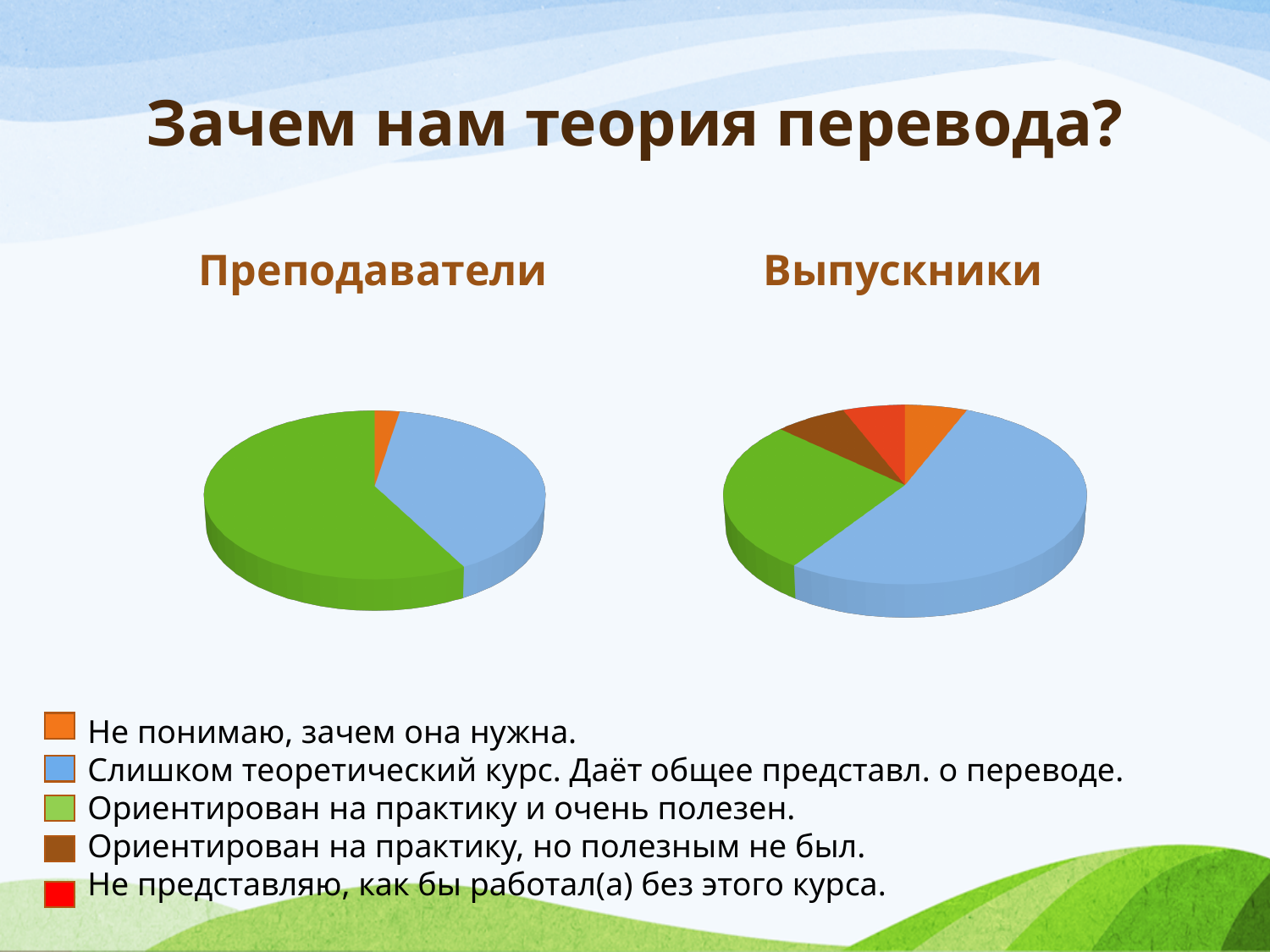
In the "Преподаватели" pie chart, which slice is larger: "Ориентирован на практику и очень полезен." or "Слишком теоретический курс. Даёт общее представл. о переводе."? Ориентирован на практику и очень полезен. Which colour represents "Ориентирован на практику, но полезным не был." in the legend? Brown In the "Выпускники" pie chart, which category has the largest slice? Слишком теоретический курс. Даёт общее представл. о переводе. In the "Выпускники" pie chart, which slice is larger: "Слишком теоретический курс. Даёт общее представл. о переводе." or "Ориентирован на практику и очень полезен."? Слишком теоретический курс. Даёт общее представл. о переводе. How many slices does the "Выпускники" pie chart have? 5 What kind of chart is used under the heading "Выпускники"? Pie chart What is the title of the slide containing the two pie charts? Зачем нам теория перевода? What kind of chart is used under the heading "Преподаватели"? Pie chart How many entries does the legend at the bottom of the slide list? 5 In the "Преподаватели" pie chart, which category has the smallest slice? Не понимаю, зачем она нужна. How many slices does the "Преподаватели" pie chart have? 3 In the "Преподаватели" pie chart, which category has the largest slice? Ориентирован на практику и очень полезен.